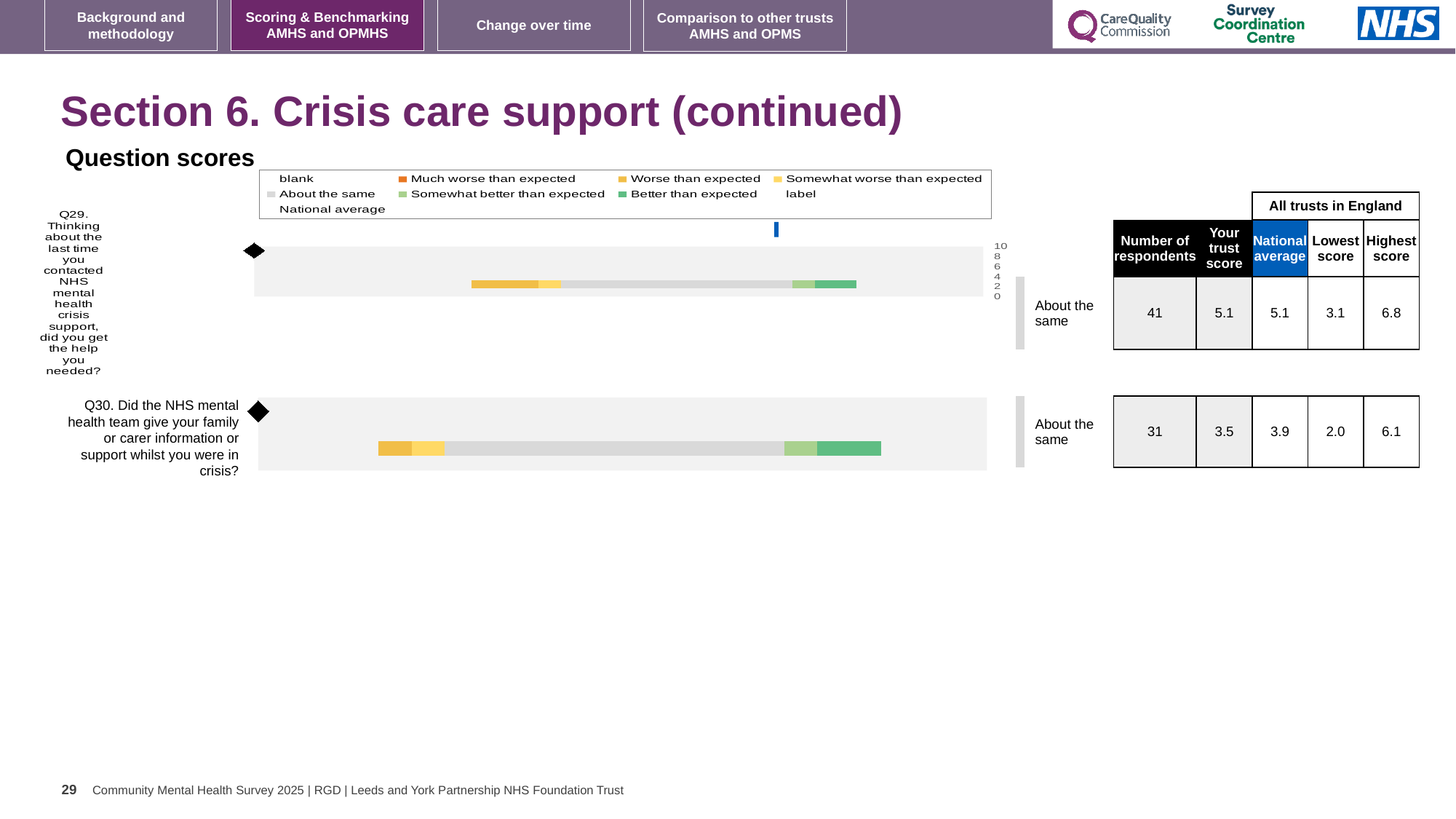
How many questions (bars) are plotted in the chart? 2 How many respondents answered Q30? 31 What is the 'Your trust score' for Q29? 5.1 What is the difference between the highest score and the lowest score for Q29? 3.7 What kind of chart is shown under 'Question scores'? bar chart What colour represents 'Better than expected' in the chart legend? Green Which question had more respondents, Q29 or Q30? Q29 How many more respondents answered Q29 than Q30? 10 For Q30, which is larger: the trust score or the national average? National average What is the highest score among all trusts in England for Q30? 6.1 What benchmark category is shown for Q29 next to the chart? About the same What is the national average for Q30? 3.9